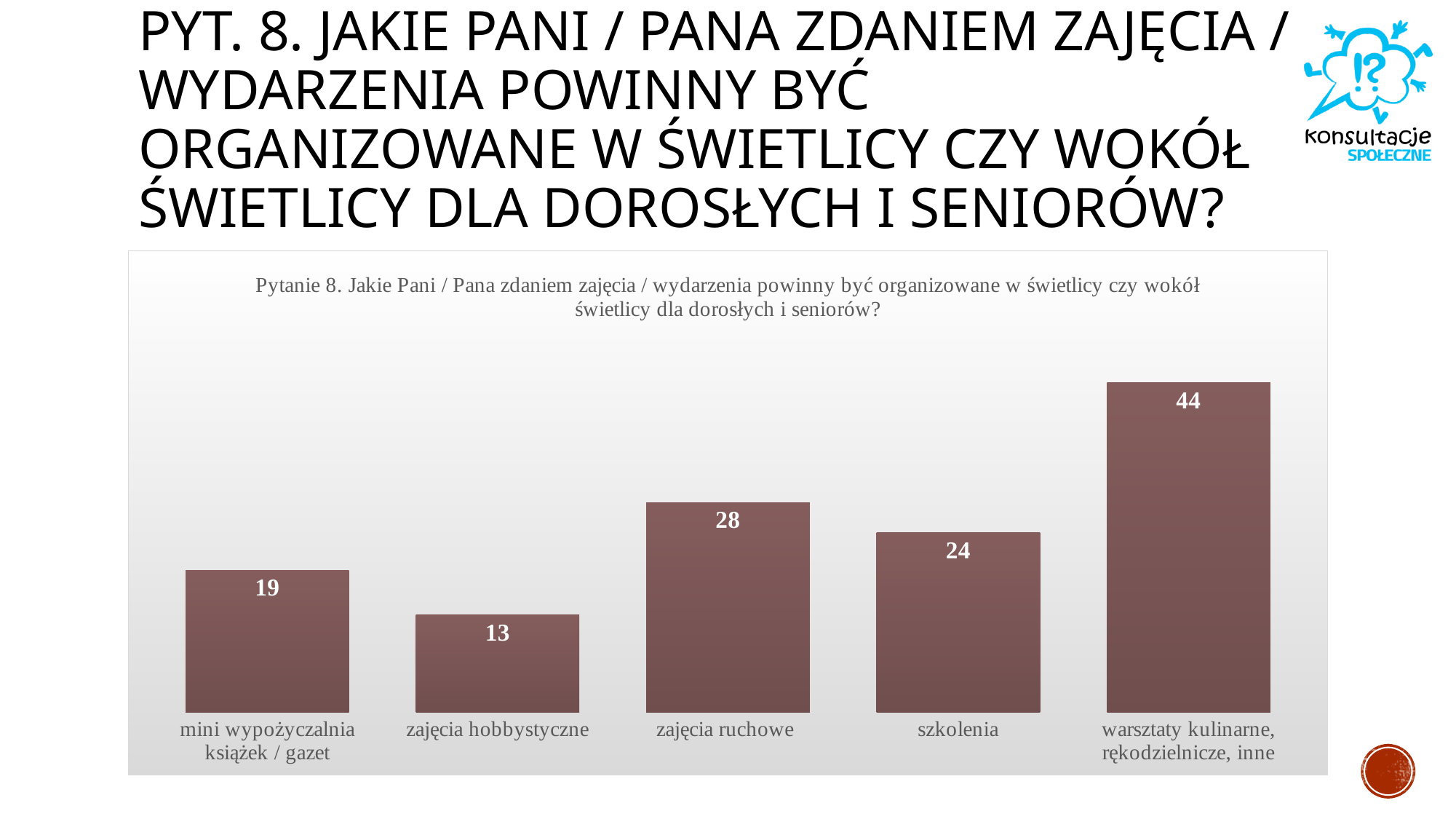
What is the value for 'mini wypożyczalnia książek / gazet'? 19 What is the difference between the values for 'warsztaty kulinarne, rękodzielnicze, inne' and 'zajęcia ruchowe'? 16 How many categories are shown in the chart? 5 What is the difference between the values for 'szkolenia' and 'zajęcia hobbystyczne'? 11 What kind of chart is shown on the slide? bar chart Which is larger, the value for 'zajęcia ruchowe' or the value for 'szkolenia'? zajęcia ruchowe What is the title of the chart? Pytanie 8. Jakie Pani / Pana zdaniem zajęcia / wydarzenia powinny być organizowane w świetlicy czy wokół świetlicy dla dorosłych i seniorów? What is the value for 'szkolenia'? 24 Which category has the lowest value? zajęcia hobbystyczne What is the value for 'zajęcia ruchowe'? 28 Which category has the highest value? warsztaty kulinarne, rękodzielnicze, inne What is the value for 'zajęcia hobbystyczne'? 13